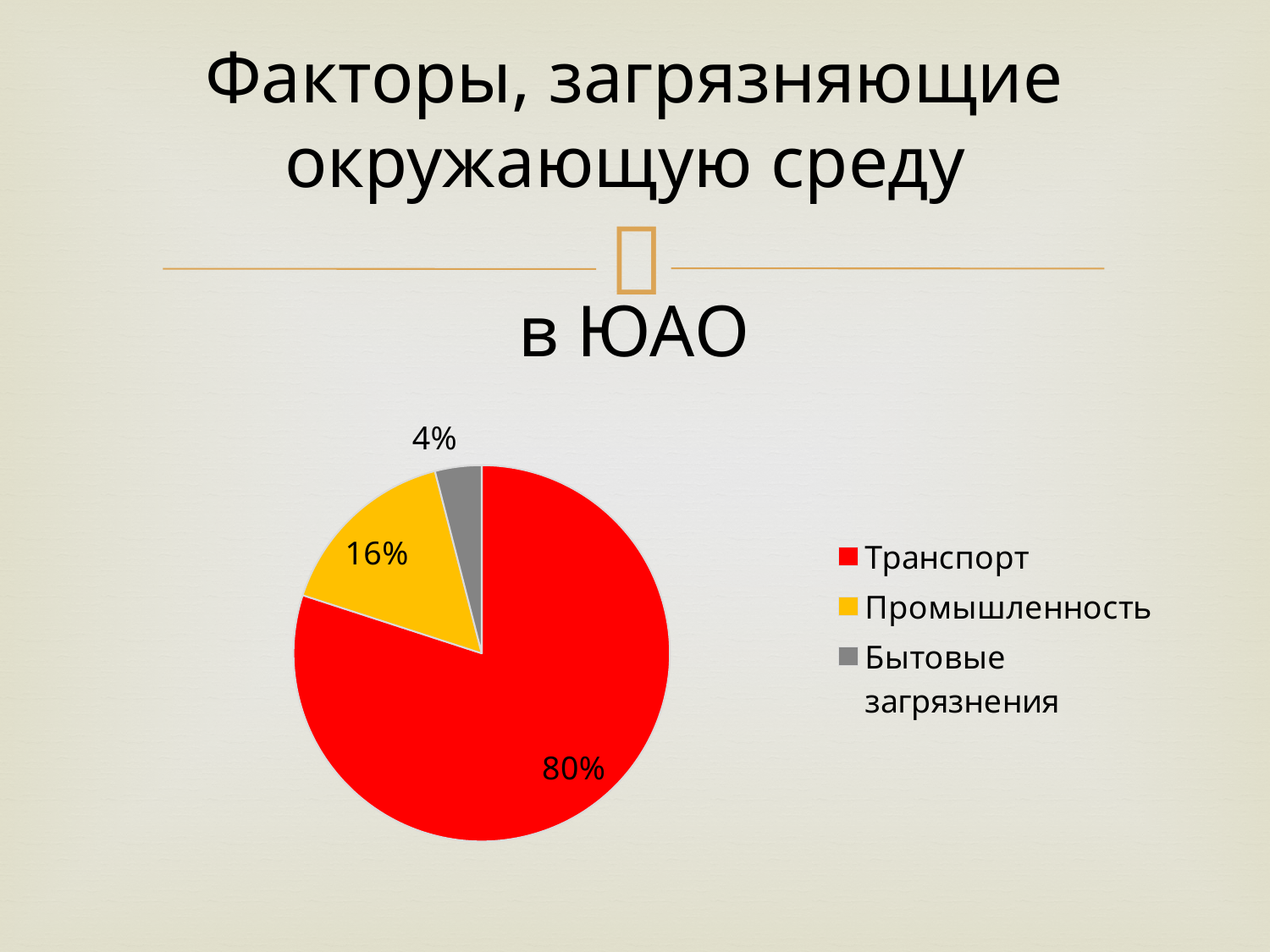
How many categories does the pie chart have? 3 What is the difference in percentage points between Промышленность and Бытовые загрязнения? 12 Which category has the largest slice of the pie? Транспорт What share of the pie does Транспорт have? 80% What share of the pie does Промышленность have? 16% Which category is shown in yellow in the legend? Промышленность Which is larger, the slice for Промышленность or the slice for Бытовые загрязнения? Промышленность What share of the pie does Бытовые загрязнения have? 4% Which category has the smallest slice of the pie? Бытовые загрязнения What colour is the slice for Транспорт? red What is the difference in percentage points between Транспорт and Промышленность? 64 What kind of chart is shown on the slide? pie chart